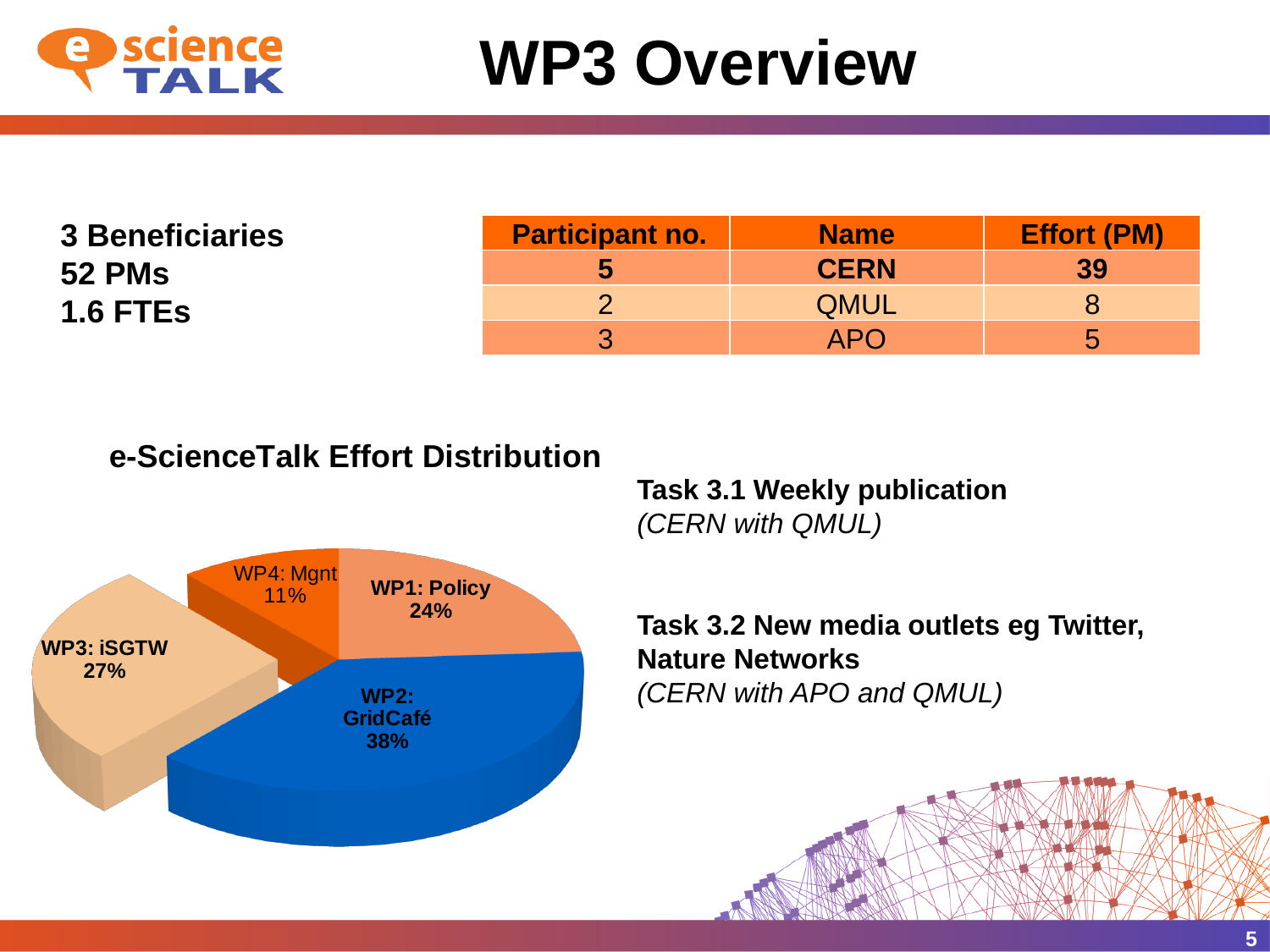
What share of effort does WP3: iSGTW have in the pie chart? 27% What share of effort does WP2: GridCafé have in the pie chart? 38% What type of chart is the e-ScienceTalk Effort Distribution chart? pie chart Which work package has the smallest slice in the pie chart? WP4: Mgnt Which has a larger share in the pie chart, WP3: iSGTW or WP1: Policy? WP3: iSGTW What share of effort does WP1: Policy have in the pie chart? 24% What is the title of the pie chart? e-ScienceTalk Effort Distribution How many slices does the pie chart have? 4 Which work package has the largest slice in the pie chart? WP2: GridCafé What colour is the WP2: GridCafé slice in the pie chart? blue What is the difference in percentage points between WP2: GridCafé and WP1: Policy in the pie chart? 14